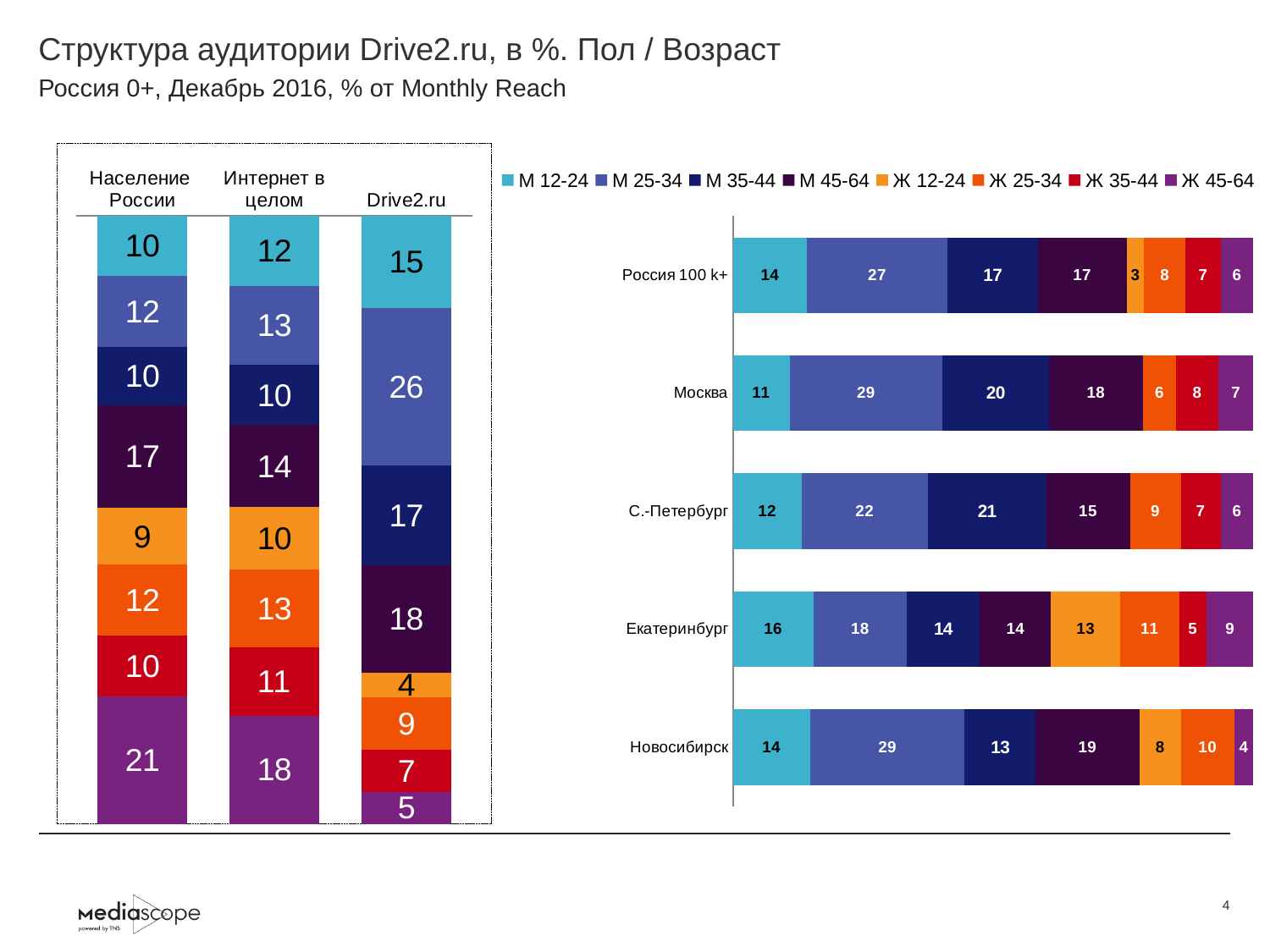
In the right-hand chart, what is the value for М 12-24 in Екатеринбург? 16 In the right-hand chart, what is the difference between the М 25-34 values for Новосибирск and С.-Петербург? 7 In the left-hand chart, what is the total of the Drive2.ru stacked bar? 101 In the right-hand chart, which row has the lowest value for М 12-24? Москва In the right-hand chart, what is the value for М 25-34 in Москва? 29 In the left-hand chart, what is the value of the Ж 45-64 segment for Население России? 21 In the left-hand chart, what is the value of the М 25-34 segment for Drive2.ru? 26 How many series does the legend of the right-hand chart list? 8 In the left-hand chart, which is larger: the М 45-64 segment for Население России or for Интернет в целом? Население России In the right-hand chart, which city has the highest value for М 35-44? С.-Петербург How many rows (categories) are shown in the right-hand chart? 5 What type of chart is the right-hand chart? Stacked bar chart